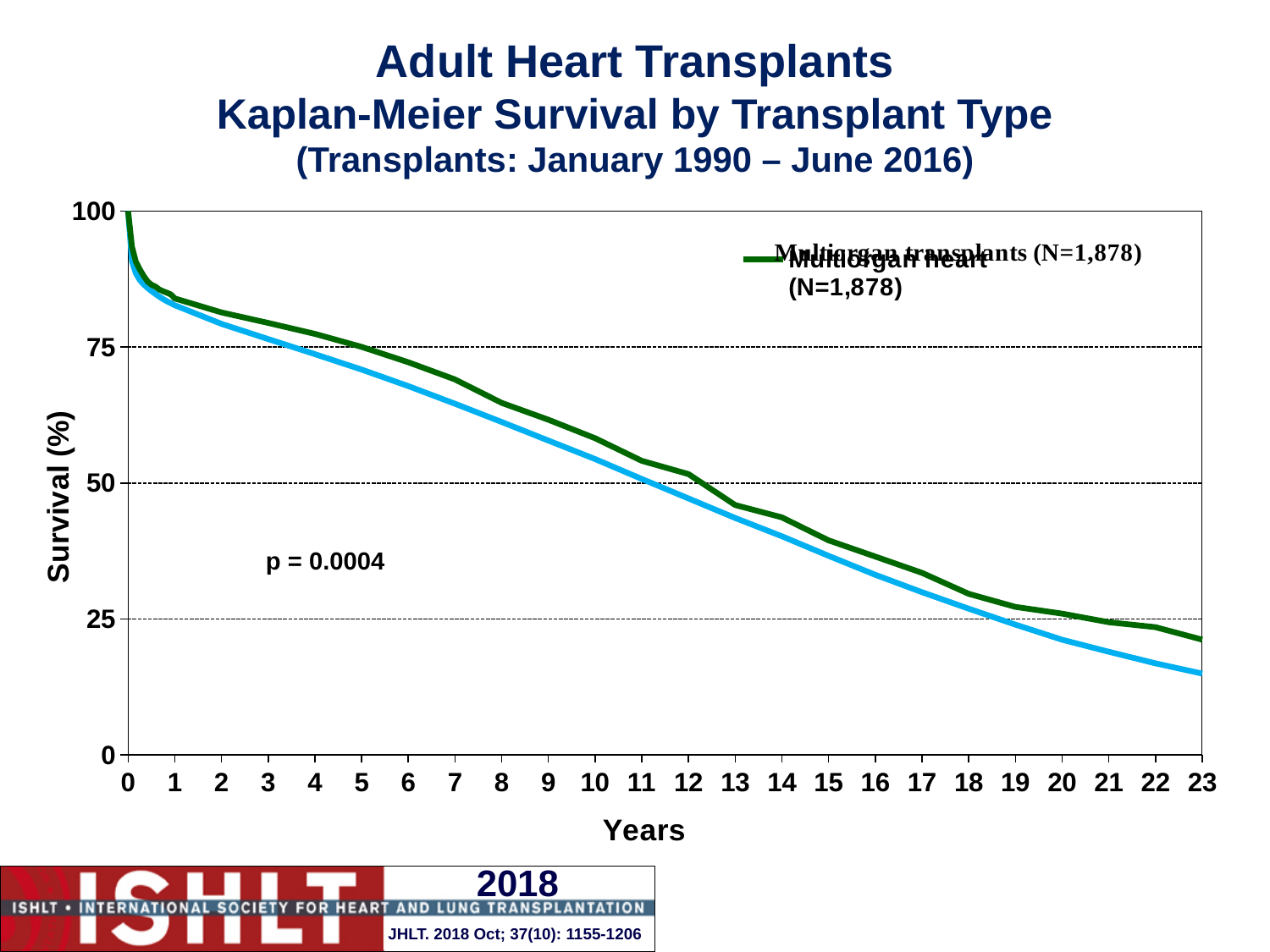
Is the survival value for the blue curve at year 15 greater or less than 50? less Is the survival value for the green (multiorgan heart) curve at year 1 greater or less than 75? greater How many survival curves are plotted on the chart? 2 Is the survival value for the green (multiorgan heart) curve at year 10 greater or less than 50? greater At year 10, which curve shows higher survival, the green curve or the blue curve? green curve What is the highest year shown on the x-axis? 23 Do the survival curves rise or fall as years since transplant increase? fall What kind of chart is shown on the slide? line chart What p-value is printed on the chart? p = 0.0004 What is the label of the y-axis? Survival (%)